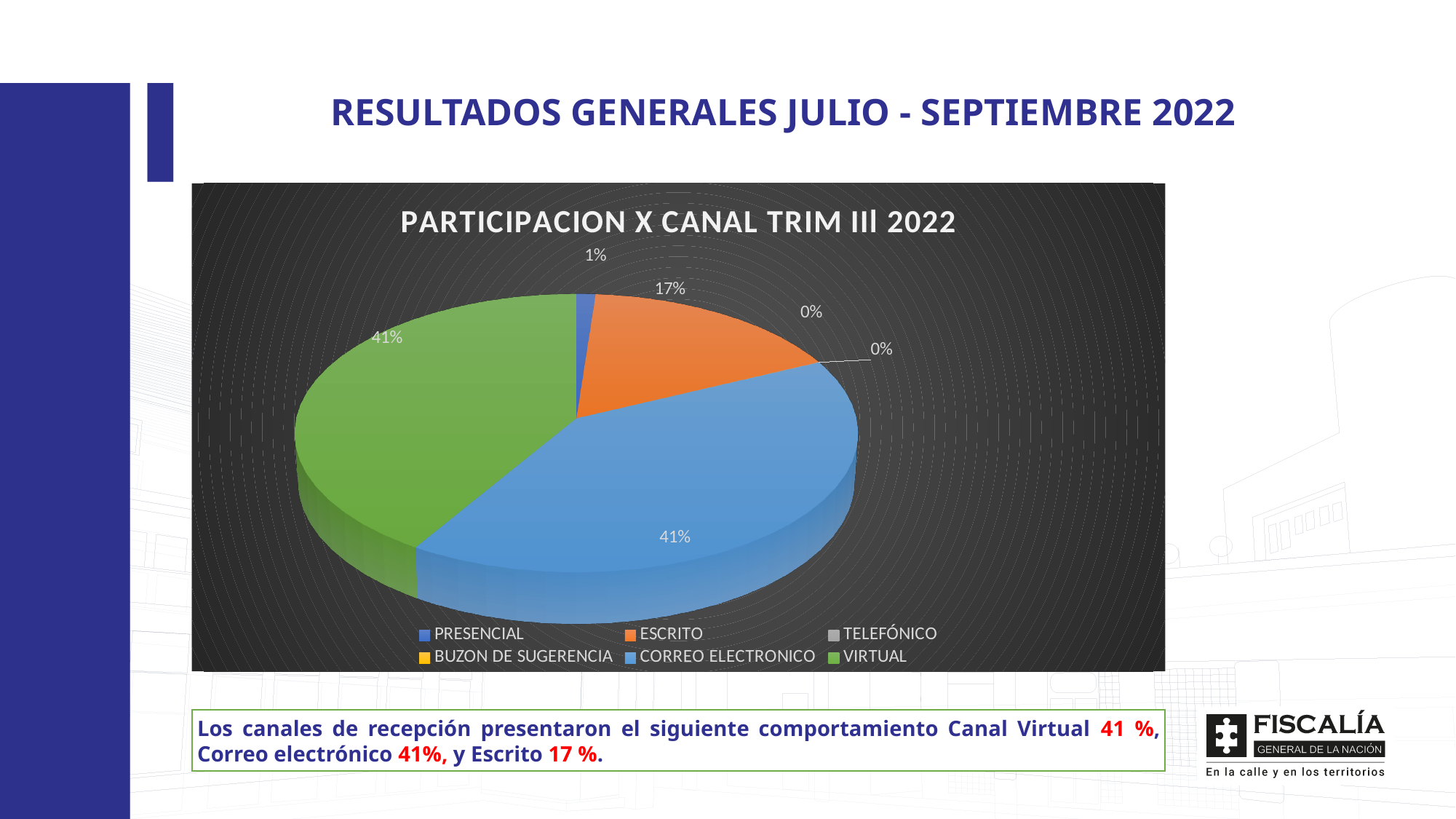
What is the difference in percentage points between VIRTUAL and ESCRITO? 24 Which slice is larger, ESCRITO or PRESENCIAL? ESCRITO How many categories does the legend list? 6 What share of the pie does PRESENCIAL have? 1% What share of the pie does TELEFÓNICO have? 0% What colour represents VIRTUAL in the chart? green What share of the pie does CORREO ELECTRONICO have? 41% What is the difference in percentage points between ESCRITO and PRESENCIAL? 16 What kind of chart is shown on the slide? pie chart What is the chart's title? PARTICIPACION X CANAL TRIM IIl 2022 What share of the pie does VIRTUAL have? 41% What share of the pie does ESCRITO have? 17%